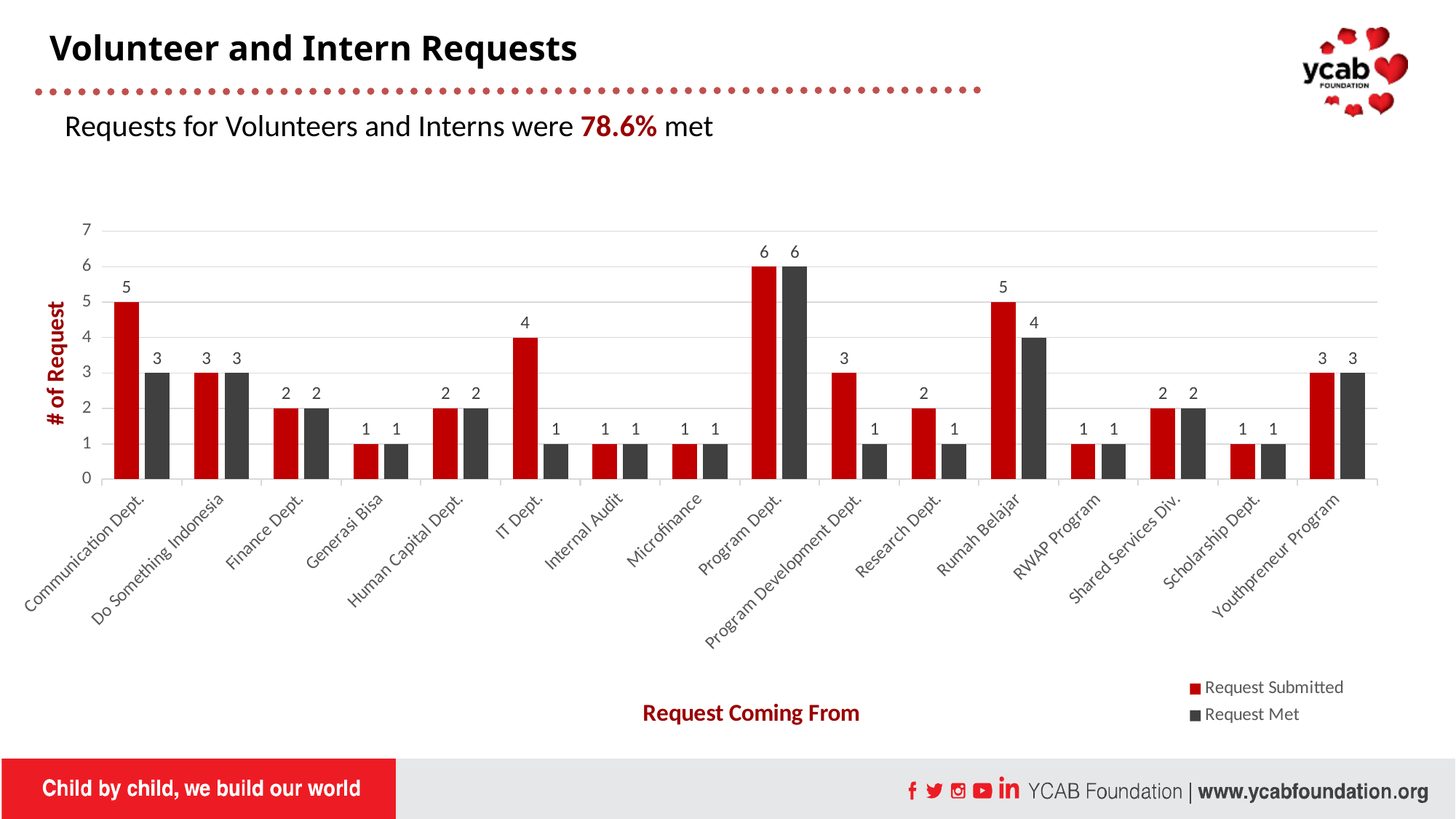
Which colour represents Request Met in the legend? Dark grey Which is larger for Program Development Dept., Request Submitted or Request Met? Request Submitted What kind of chart is shown on the slide? Bar chart How many series does the legend list? 2 What is the label of the y axis? # of Request Which department has the highest number of Request Submitted? Program Dept. How many Request Submitted were there for Communication Dept.? 5 How many departments or programs are shown on the x axis? 16 How many Request Submitted were there for IT Dept.? 4 How many Request Met were there for Rumah Belajar? 4 What is the difference between Request Submitted and Request Met for IT Dept.? 3 What is the difference between Request Submitted and Request Met for Communication Dept.? 2